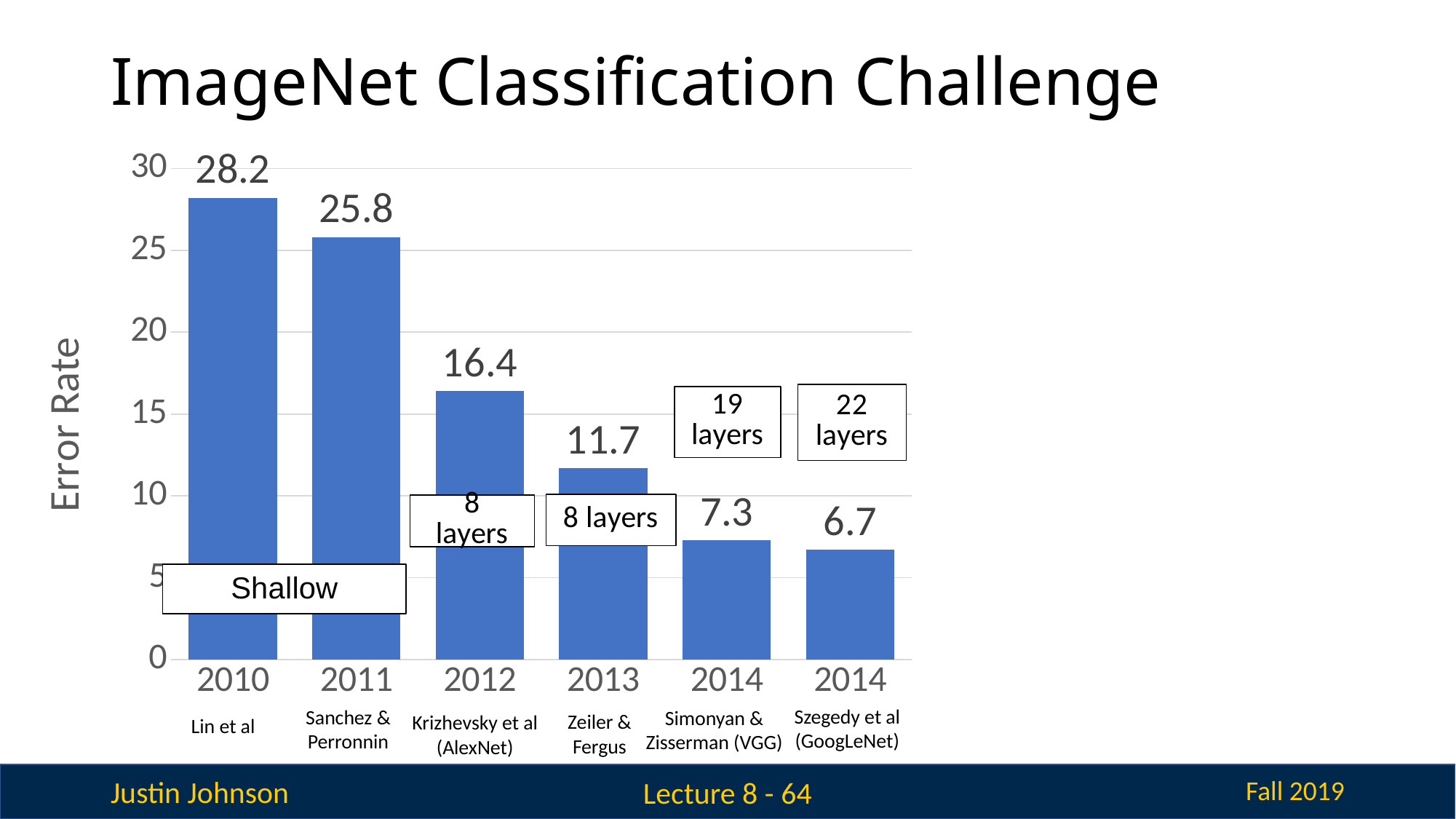
Do the error rates rise or fall from 2010 to 2014 along the x axis? Fall How many bars are shown in the chart? 6 What kind of chart is shown on the slide? Bar chart Is the error rate for 2013 (Zeiler & Fergus) greater or less than 10? greater Which bar has the highest error rate? 2010 (Lin et al) Which has a larger error rate, 2013 (Zeiler & Fergus) or 2014 (Simonyan & Zisserman, VGG)? 2013 (Zeiler & Fergus) What is the error rate for 2012 (Krizhevsky et al, AlexNet)? 16.4 What is the difference in error rate between 2011 (Sanchez & Perronnin) and 2012 (Krizhevsky et al)? 9.4 What is the label on the y axis of the chart? Error Rate What is the error rate for 2010 (Lin et al)? 28.2 Which bar has the lowest error rate? 2014 (Szegedy et al, GoogLeNet) What is the error rate for 2014 (Szegedy et al, GoogLeNet)? 6.7